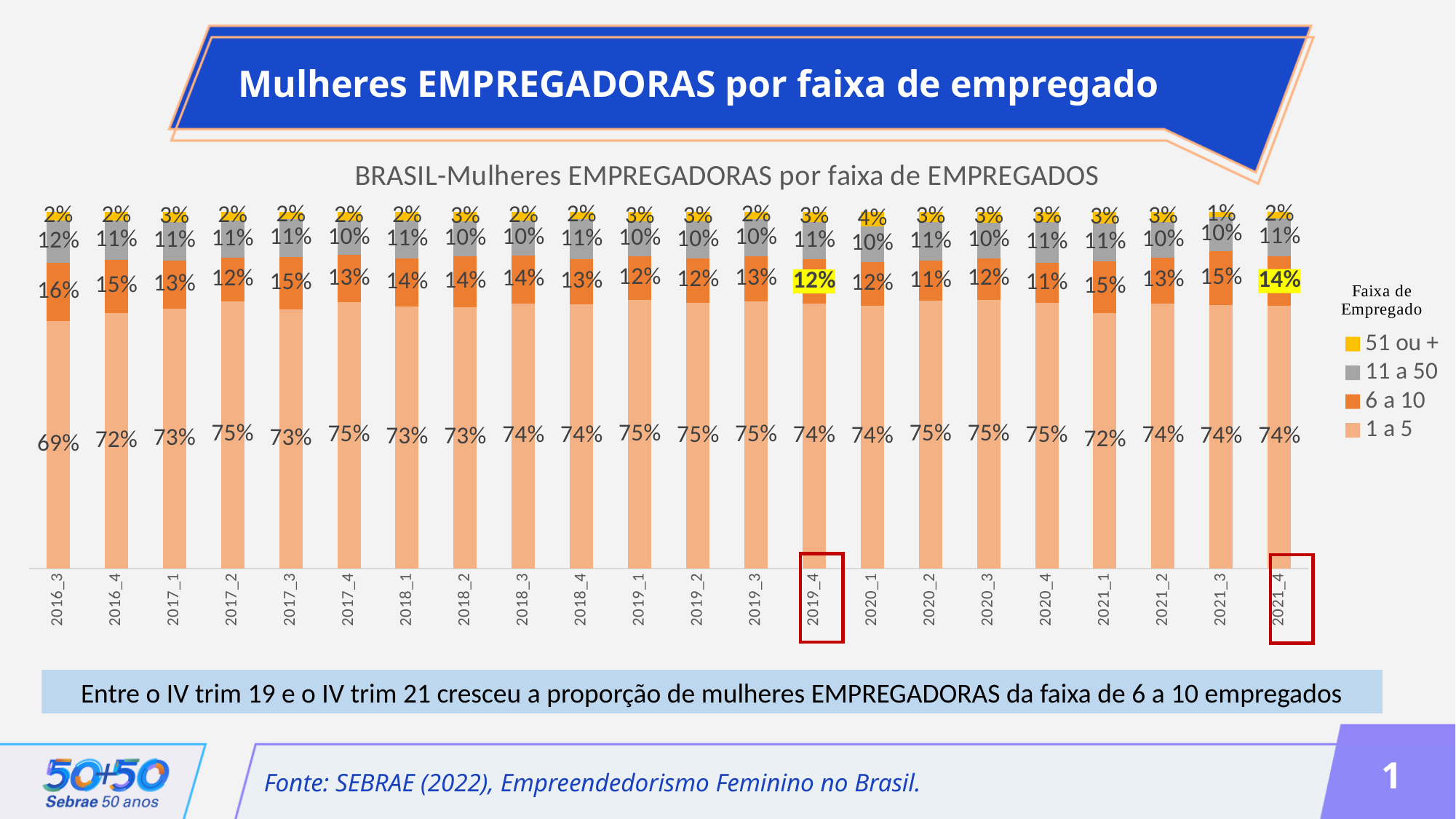
What is the value of the '51 ou +' series for 2020_1? 4% What is the value of the '1 a 5' series for 2016_3? 69% Which quarter has the lowest value for the '1 a 5' series? 2016_3 What is the value of the '6 a 10' series for 2021_4? 14% How many quarters are shown on the x axis? 22 What kind of chart is shown on the slide? Stacked bar chart What is the total of the stacked bar for 2019_4? 100% Which quarter has the highest value for the '6 a 10' series? 2016_3 How many series does the legend list? 4 Which is larger, the '1 a 5' value for 2016_3 or for 2017_2? 2017_2 Which quarter has the lowest value for the '51 ou +' series? 2021_3 What is the difference in the '6 a 10' series between 2021_4 and 2019_4? 2 percentage points